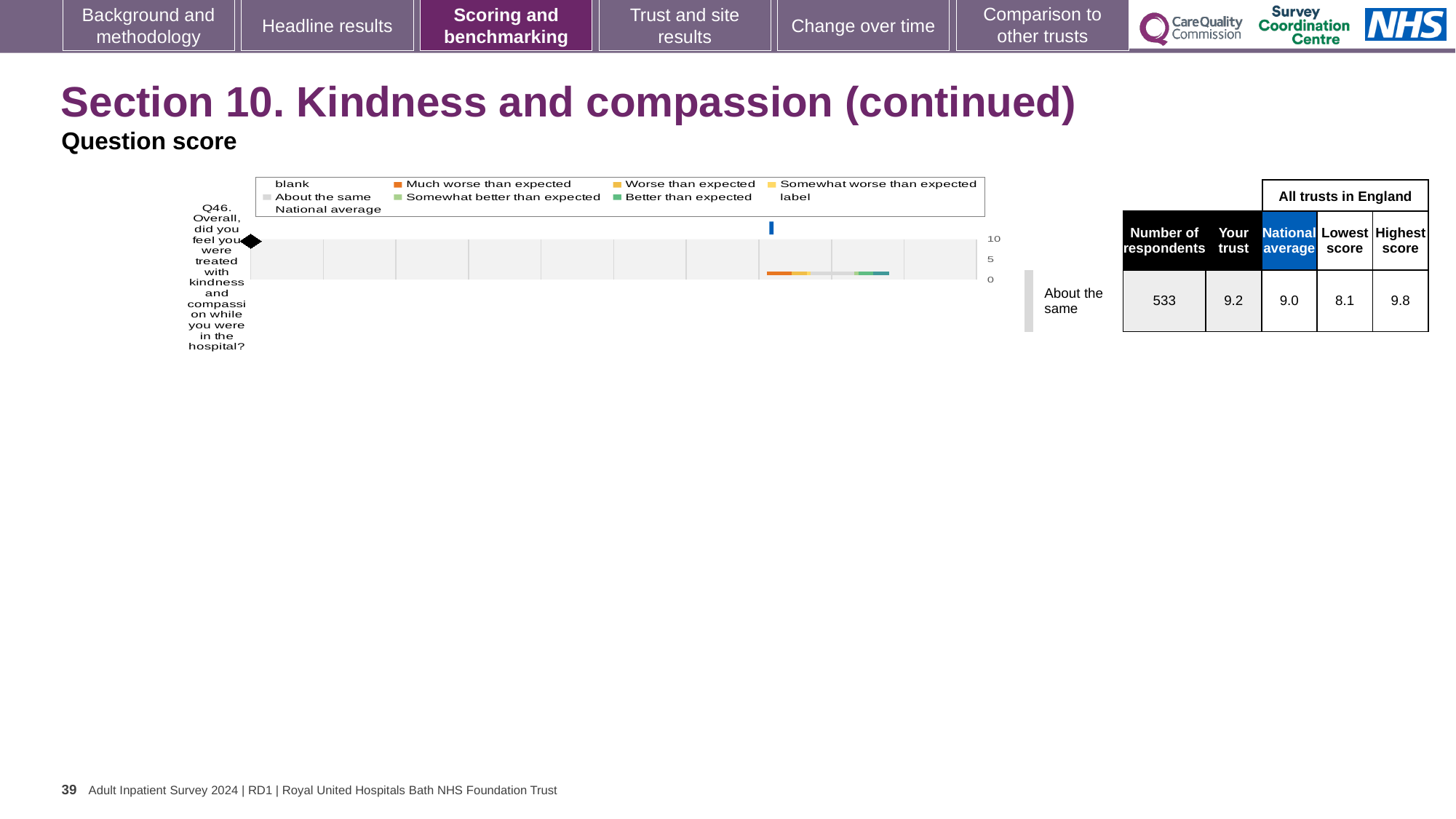
Which is larger for Q46: the Your trust score or the National average score? Your trust Which question number is plotted on the chart? Q46 According to the table beside the chart, what is the Highest score among all trusts in England for Q46? 9.8 How many entries does the chart legend list? 9 What is the highest value shown on the chart's score axis? 10 According to the table beside the chart, what is the Lowest score among all trusts in England for Q46? 8.1 Is the national average marker on the chart greater or less than 5? greater According to the table beside the chart, what is the score for Your trust on Q46? 9.2 What is the difference between the Highest score and the Lowest score for Q46? 1.7 According to the table beside the chart, what is the National average score for Q46? 9.0 What kind of chart is shown on the slide? bar chart How many questions (categories) are plotted on the chart? 1